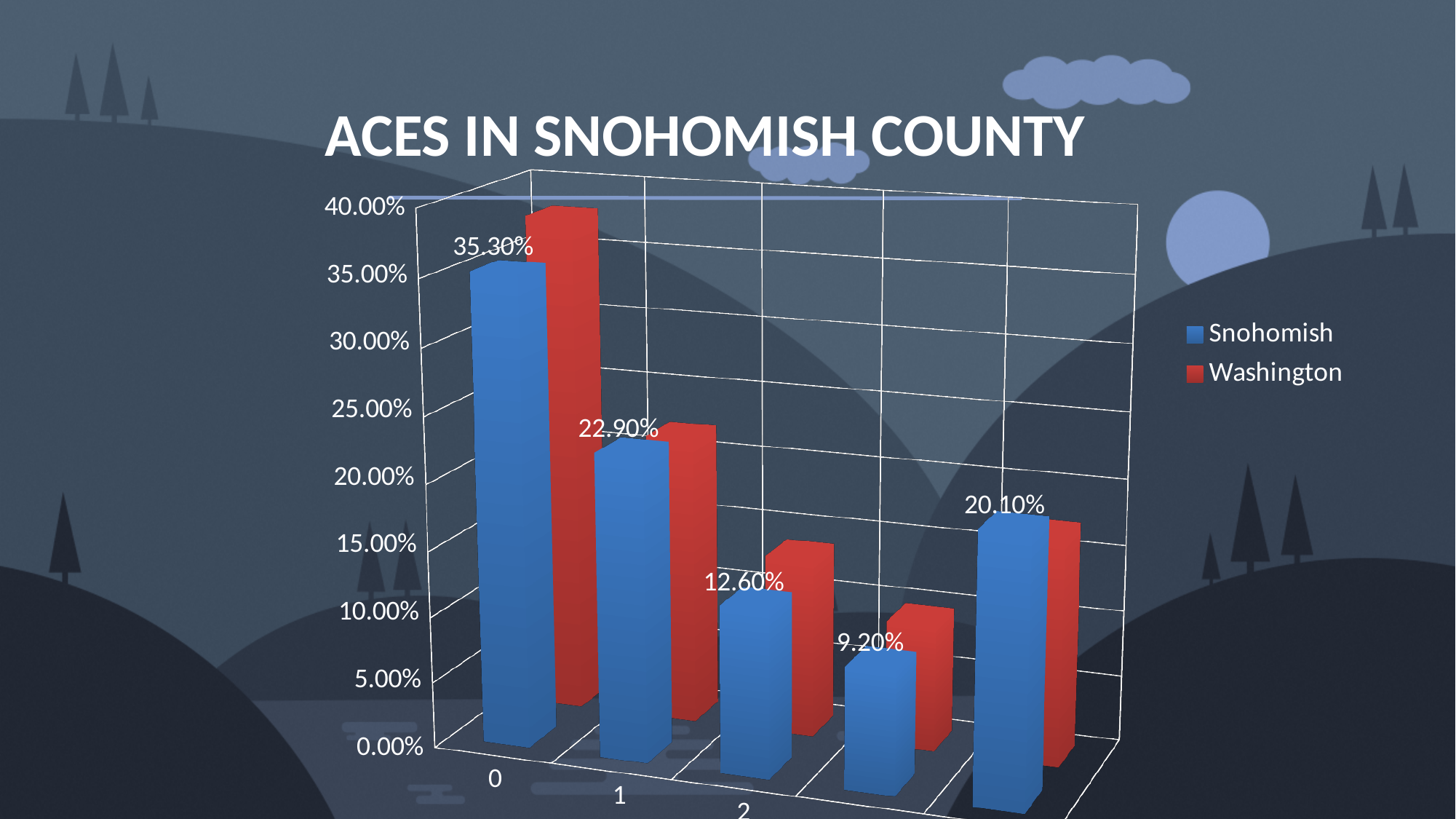
What is the Snohomish value for category 2? 12.60% How many series does the legend list? 2 What is the Snohomish value for category 0? 35.30% Which category has the highest Snohomish value? 0 For category 0, which series has the larger value, Snohomish or Washington? Washington What is the difference between the Snohomish values for category 0 and category 1? 12.40% Do the Snohomish values rise or fall from category 0 to category 2? Fall What is the Snohomish value for category 1? 22.90% Is the Washington value for category 2 greater or less than 10.00%? greater What is the lowest Snohomish value shown on the chart? 9.20% What kind of chart is shown on the slide? Bar chart Is the Washington value for category 0 greater or less than 35.00%? greater